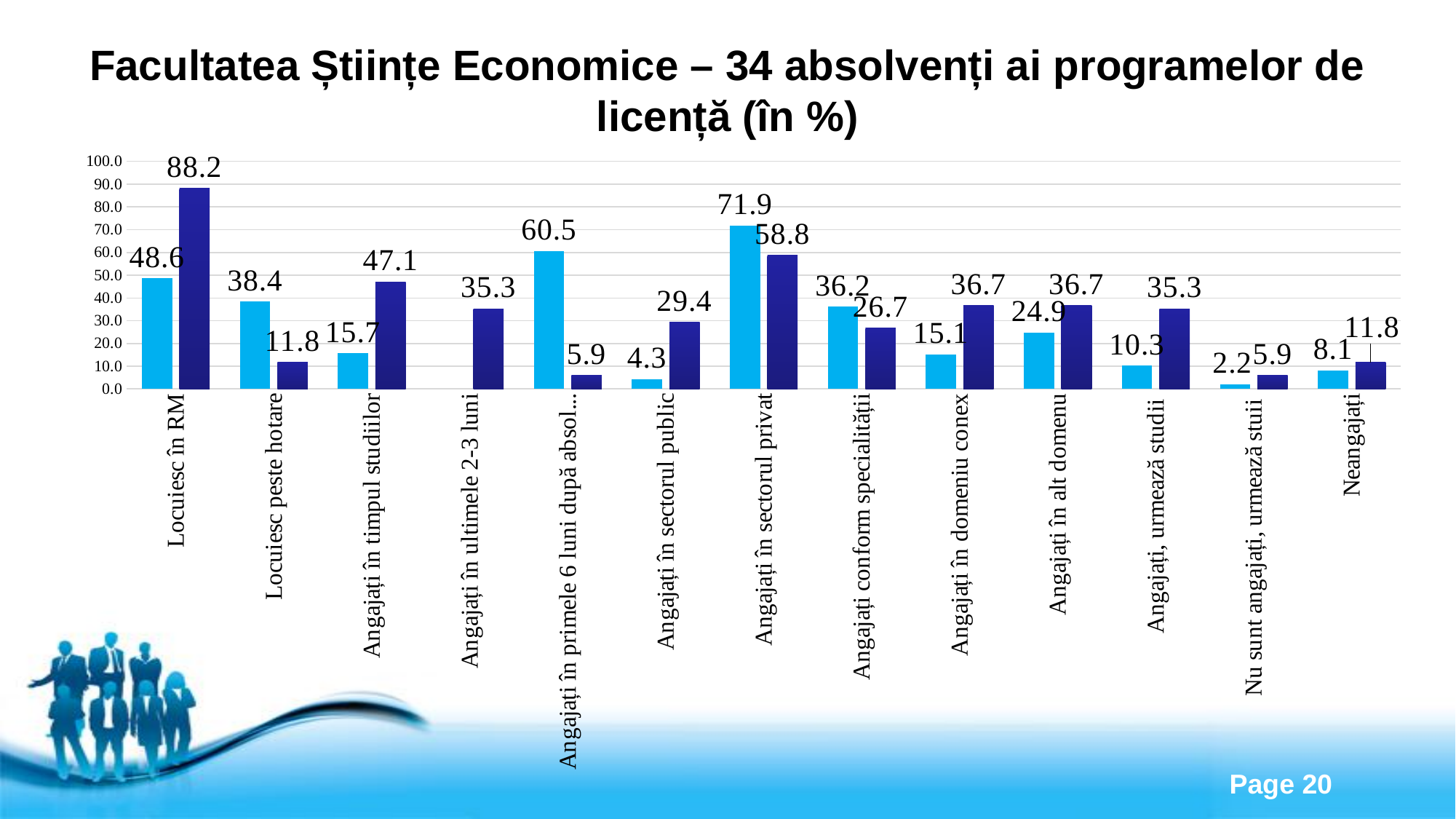
Which category has the lowest light blue bar? Nu sunt angajați, urmează stuii What is the value of the light blue bar for "Angajați în primele 6 luni după absol..."? 60.5 What type of chart is shown on the slide? bar chart Is the light blue bar for "Locuiesc peste hotare" greater or less than 30.0? greater What is the value of the dark blue bar for "Locuiesc în RM"? 88.2 What is the difference between the dark blue and light blue bars for "Locuiesc în RM"? 39.6 Which category has the highest dark blue bar? Locuiesc în RM For "Angajați în sectorul privat", which bar is larger, the light blue or the dark blue? light blue How many categories are shown on the x axis? 13 What is the value of the dark blue bar for "Angajați în sectorul public"? 29.4 What is the value of the light blue bar for "Angajați în sectorul privat"? 71.9 What is the title of the chart on the slide? Facultatea Științe Economice – 34 absolvenți ai programelor de licență (în %)